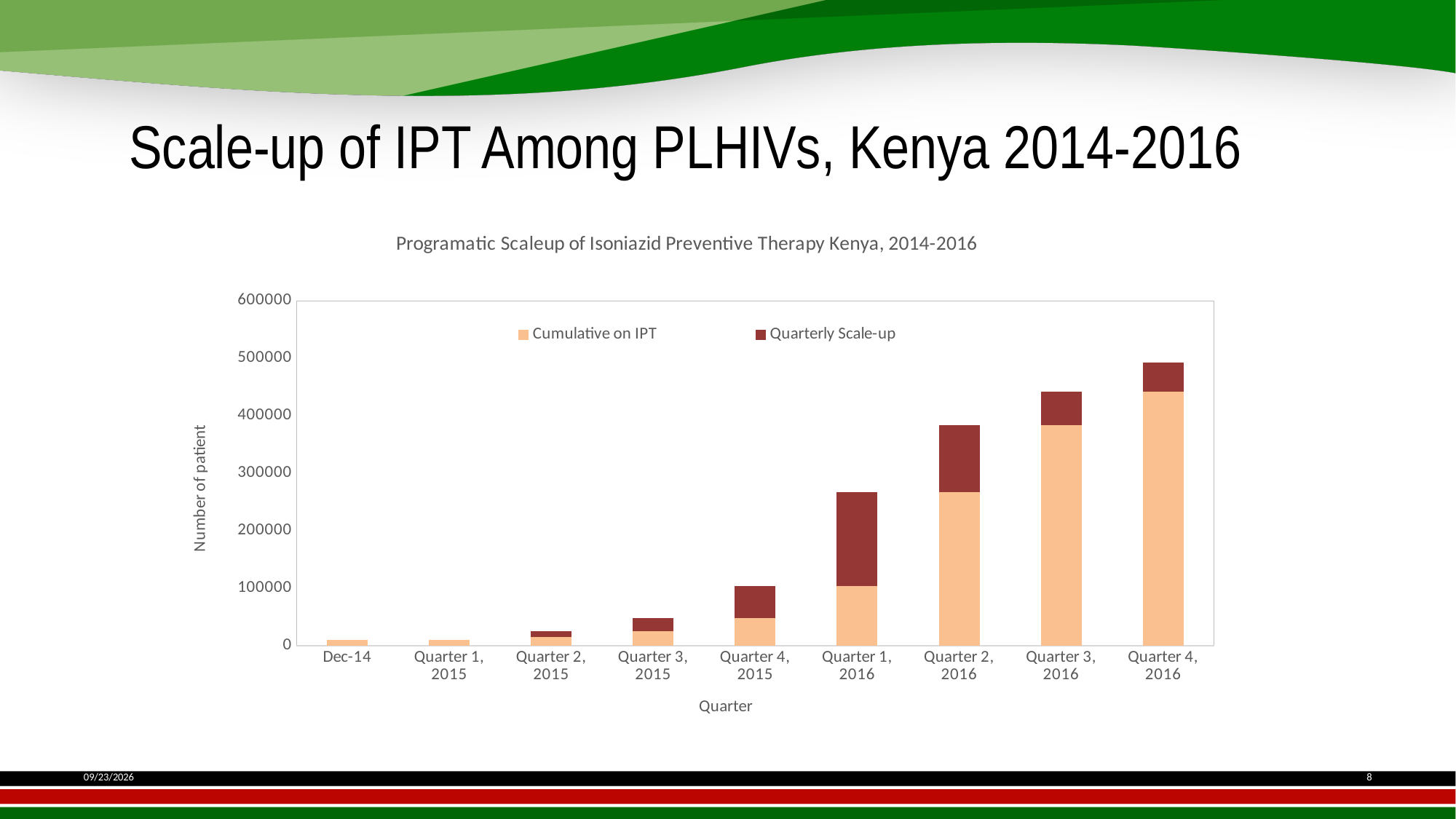
Do the stacked bar totals rise or fall from Dec-14 to Quarter 4, 2016? Rise Which is larger: the Cumulative on IPT value for Quarter 3, 2016 or for Quarter 2, 2016? Quarter 3, 2016 How many series does the chart's legend list? 2 What is the title of the chart? Programatic Scaleup of Isoniazid Preventive Therapy Kenya, 2014-2016 How many quarters (categories) are shown on the x axis of the chart? 9 Is the Cumulative on IPT value for Quarter 4, 2016 greater or less than 400000? greater Is the total height of the stacked bar for Quarter 1, 2016 greater or less than 200000? greater Is the Cumulative on IPT value for Quarter 2, 2016 greater or less than 200000? greater What kind of chart is shown on the slide? Stacked bar chart Which quarter has the tallest stacked bar in the chart? Quarter 4, 2016 Which quarter has the largest Quarterly Scale-up segment? Quarter 1, 2016